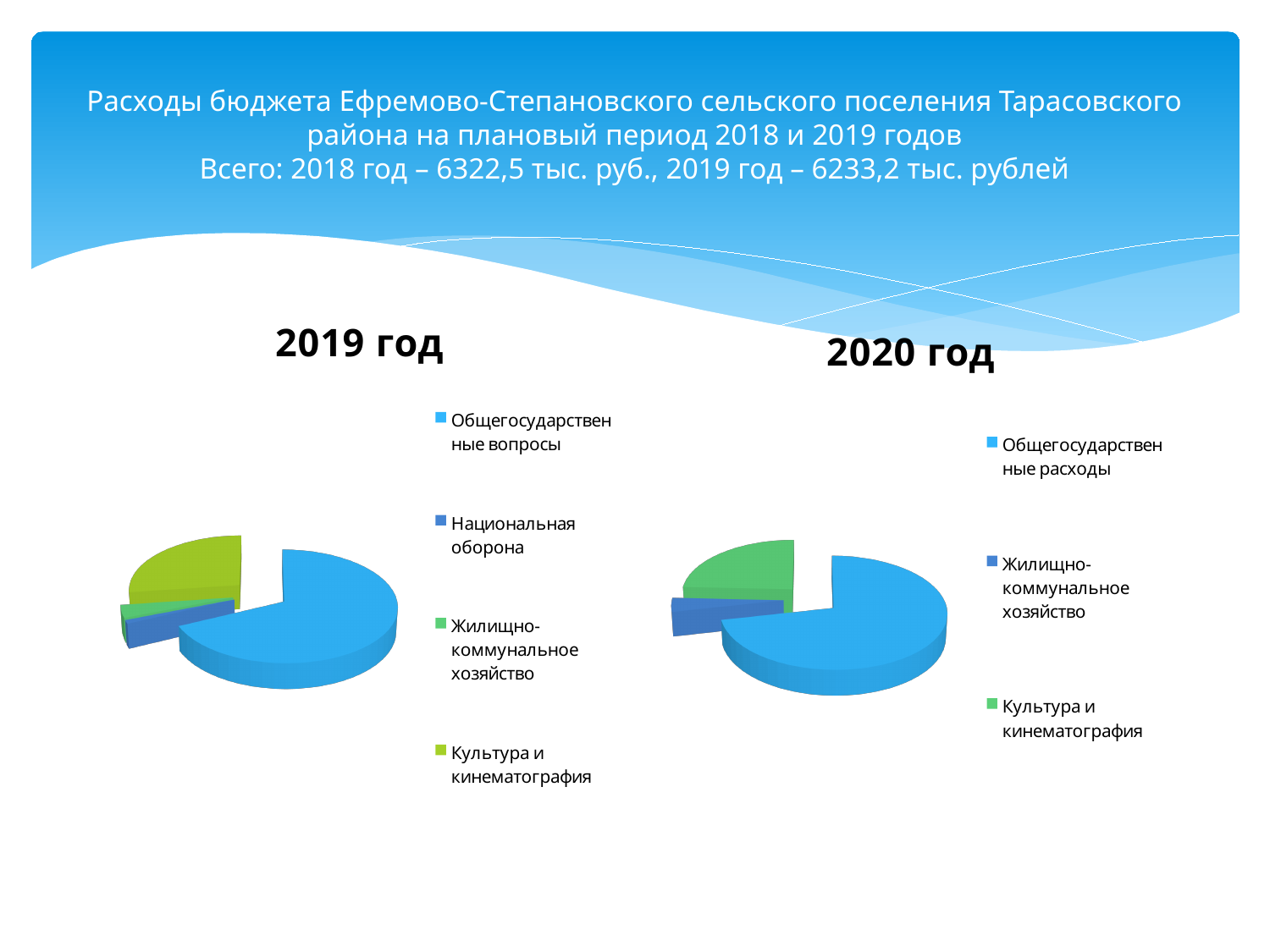
What kind of chart is the "2019 год" chart? pie chart In the "2020 год" chart, how many categories does the legend list? 3 In the "2019 год" chart, which category has the largest slice? Общегосударственные вопросы In the "2020 год" chart, which category has the smallest slice? Жилищно-коммунальное хозяйство What are the titles of the two pie charts on the slide? 2019 год and 2020 год In the "2020 год" chart, which slice is larger: Культура и кинематография or Жилищно-коммунальное хозяйство? Культура и кинематография Which legend entry appears in the "2019 год" chart but not in the "2020 год" chart? Национальная оборона In the "2019 год" chart, which slice is larger: Общегосударственные вопросы or Культура и кинематография? Общегосударственные вопросы In the "2019 год" chart, how many categories does the legend list? 4 What kind of chart is the "2020 год" chart? pie chart In the "2019 год" chart, which slice is larger: Общегосударственные вопросы or Национальная оборона? Общегосударственные вопросы In the "2020 год" chart, which category has the largest slice? Общегосударственные расходы